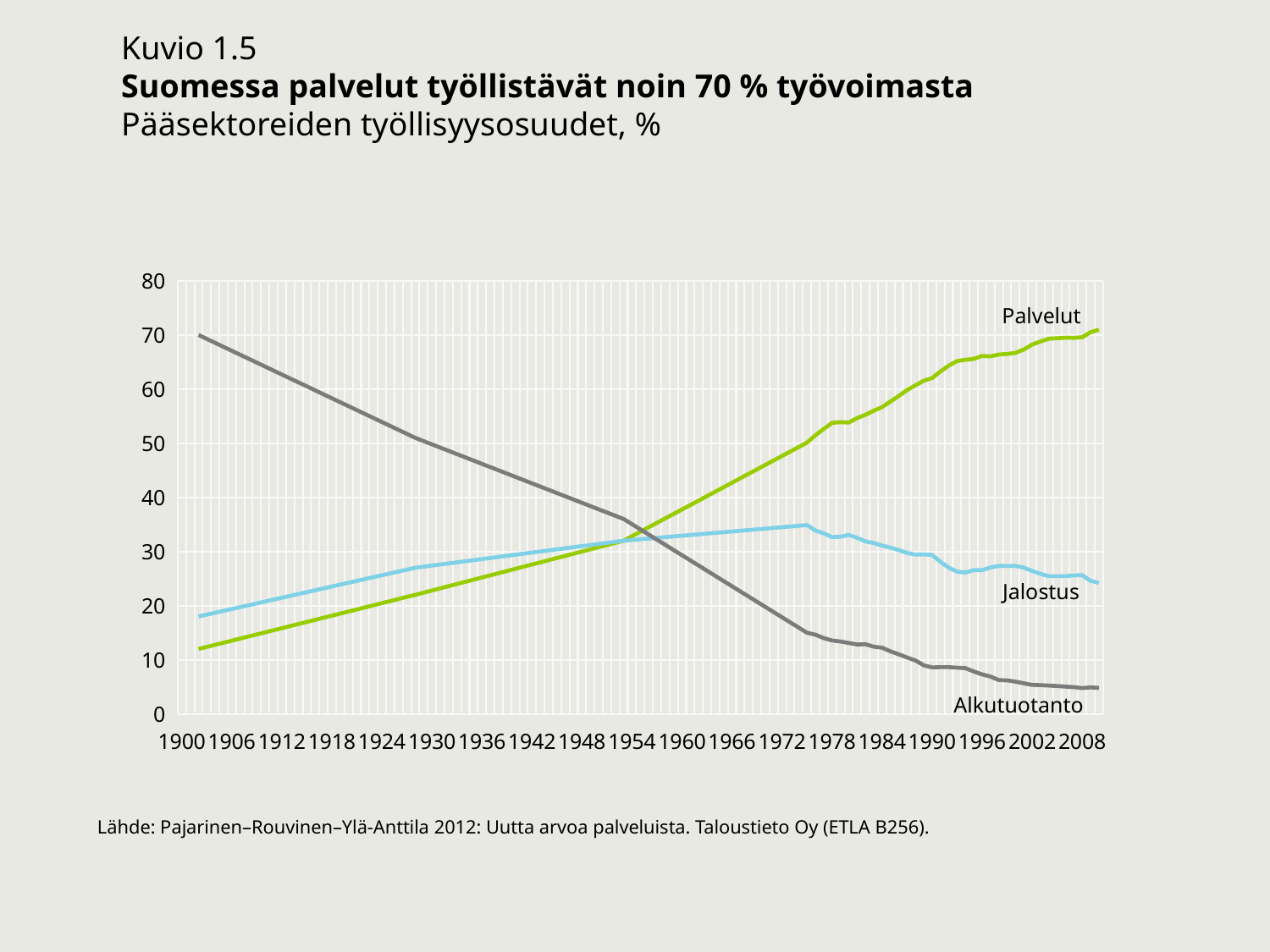
Does the Alkutuotanto line rise or fall from 1900 to 2008? Falls Does the Palvelut line rise or fall from 1900 to 2008? Rises How many series (lines) are plotted in the chart? 3 Which sector has the highest employment share in 1900? Alkutuotanto Which sector has the highest employment share in 2008? Palvelut What kind of chart is shown on the slide? Line chart Is the value for Alkutuotanto in 2008 greater or less than 10? less In 1900, which is larger: the share of Jalostus or the share of Palvelut? Jalostus Is the value for Palvelut in 2008 greater or less than 60? greater Is the value for Jalostus in 1900 greater or less than 20? less Which sector has the lowest employment share in 2008? Alkutuotanto What is the bold title of the chart on the slide? Suomessa palvelut työllistävät noin 70 % työvoimasta